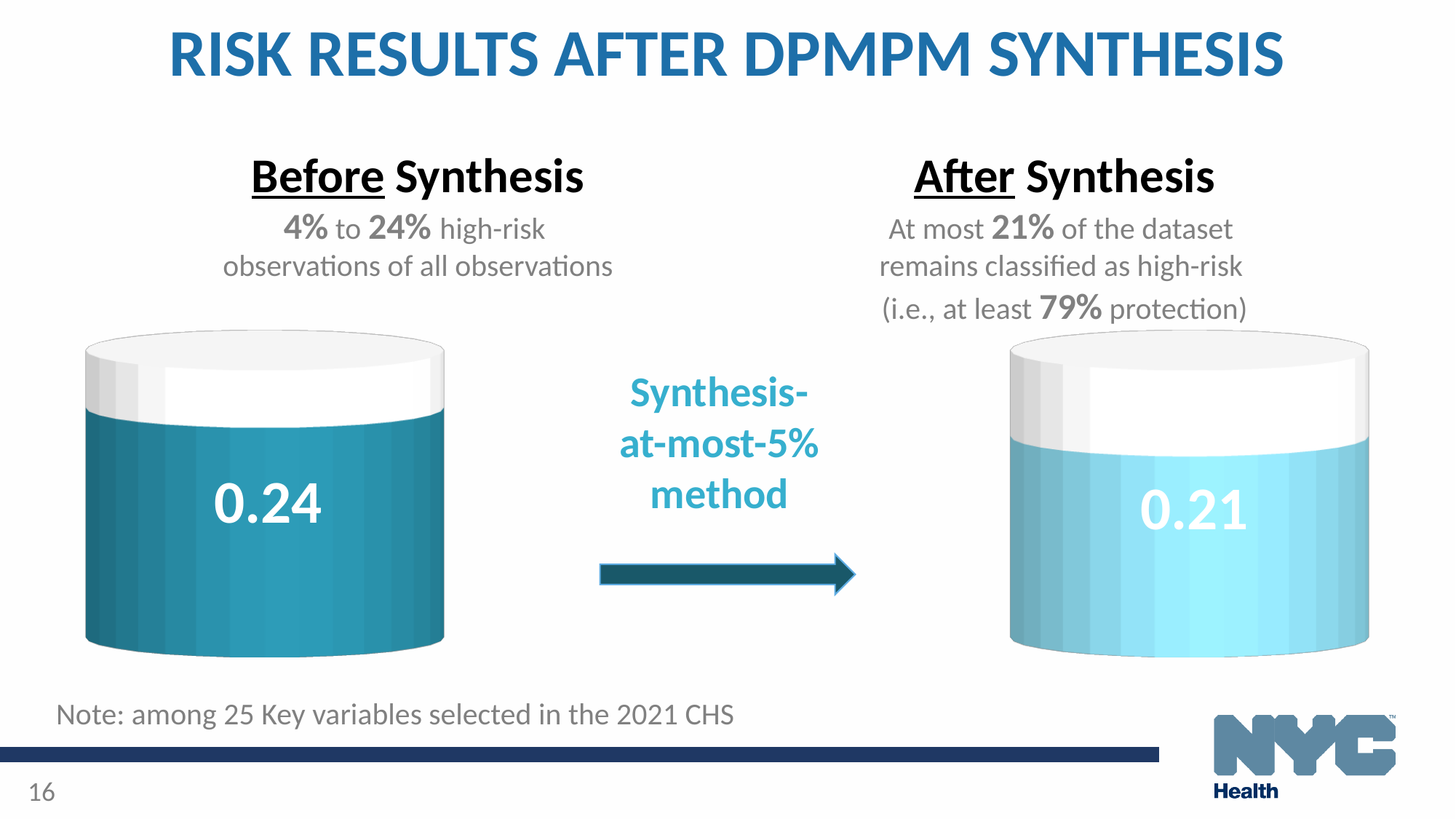
What is the difference between the Before Synthesis value and the After Synthesis value? 0.03 Which cylinder shows the higher value, Before Synthesis or After Synthesis? Before Synthesis What is the title of the slide containing the two cylinders? RISK RESULTS AFTER DPMPM SYNTHESIS How many cylinder graphics are shown on the slide? 2 What method is named between the two cylinders? Synthesis-at-most-5% method Which cylinder shows the lower value, Before Synthesis or After Synthesis? After Synthesis Is the Before Synthesis value larger or smaller than the After Synthesis value? larger What value is shown in the After Synthesis cylinder? 0.21 What value is shown in the Before Synthesis cylinder? 0.24 Does the value decrease or increase from Before Synthesis to After Synthesis? decrease